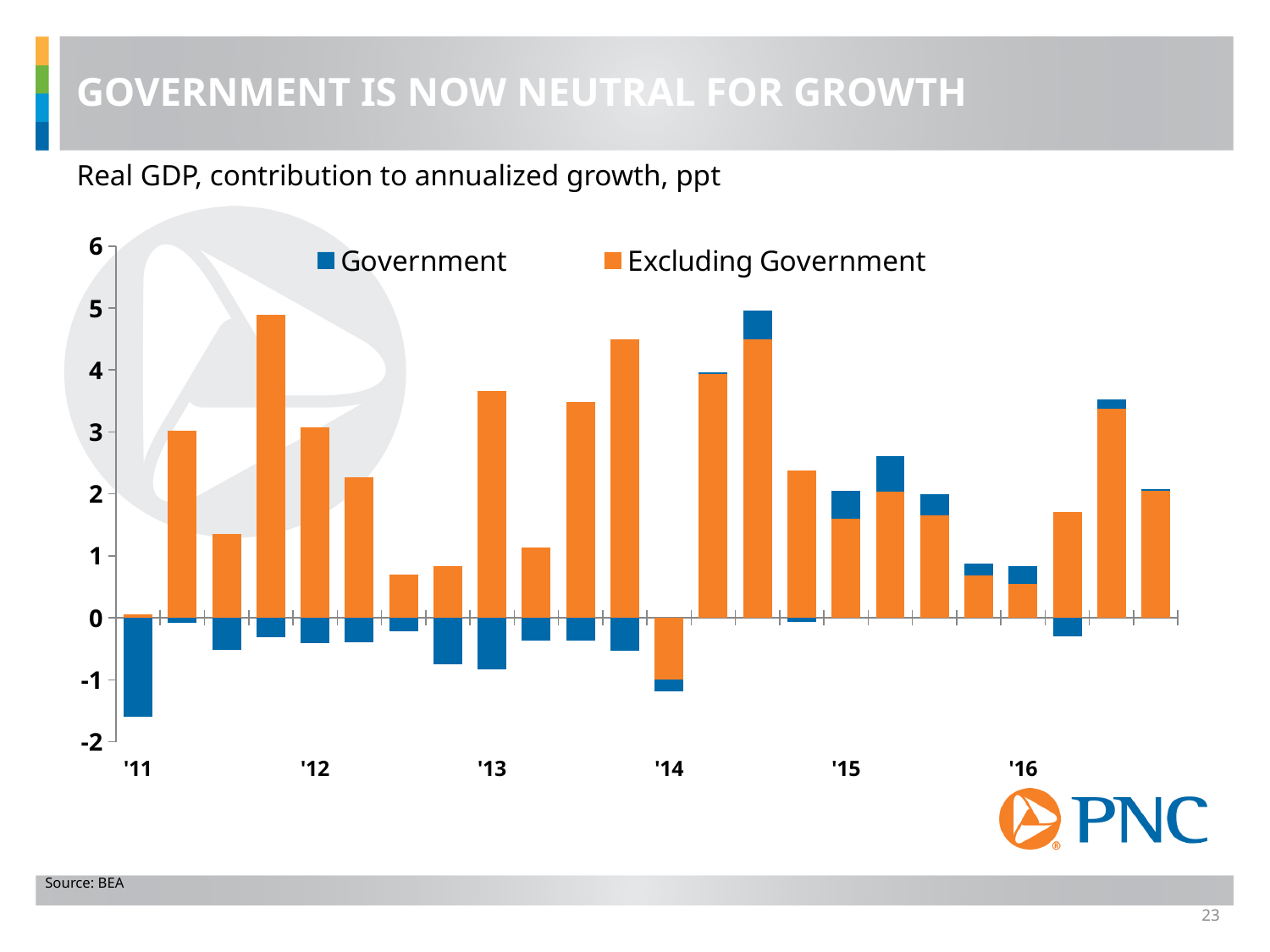
Is the Excluding Government value for the bar directly above the '13 label greater or less than 3? greater What are the two series named in the legend? Government and Excluding Government Which series contributes the negative portion of the bar directly above the '11 label? Government What is the subtitle describing the data plotted in the chart? Real GDP, contribution to annualized growth, ppt Is the Excluding Government value for the bar directly above the '14 label greater or less than 0? less How many bars (quarters) are plotted in the chart? 24 How many series does the legend list? 2 Is the Excluding Government value for the bar directly above the '16 label greater or less than 1? less What kind of chart is shown on the slide? Stacked bar chart